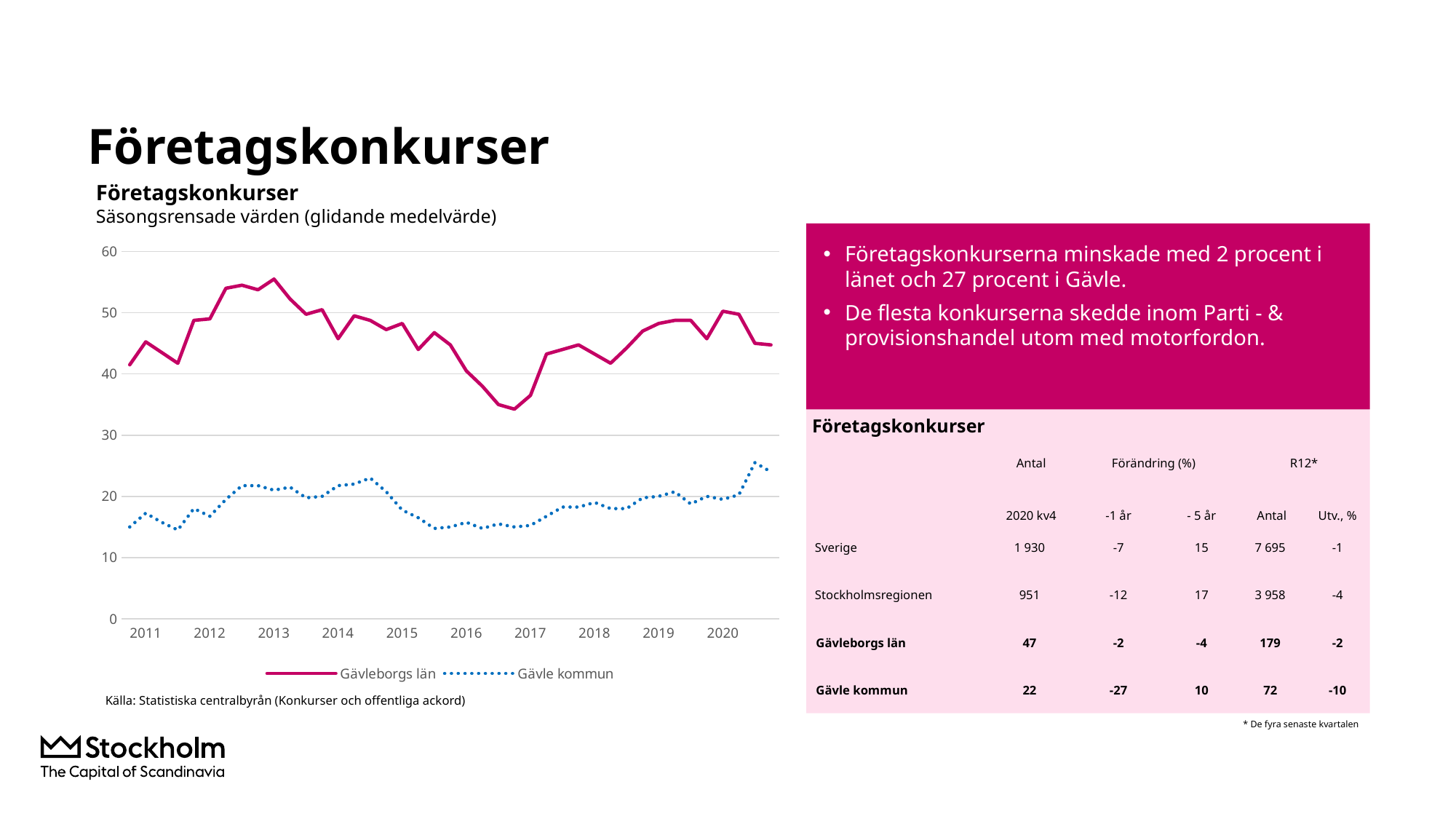
Is the value of the Gävle kommun line at the end of 2020 greater or less than 20? greater Is the value of the Gävle kommun line during 2016 greater or less than 20? less Is the lowest value of the Gävleborgs län line, around late 2016, greater or less than 40? less Does the Gävleborgs län line rise or fall between 2013 and 2016? fall What kind of chart is shown on the slide? line chart What are the two series named in the chart legend? Gävleborgs län and Gävle kommun How many series does the chart legend list? 2 Which series has higher values throughout the chart, Gävleborgs län or Gävle kommun? Gävleborgs län What is the subtitle shown under the chart title 'Företagskonkurser'? Säsongsrensade värden (glidande medelvärde) How many year labels are shown on the x axis of the chart? 10 Does the Gävle kommun line rise or fall from 2019 to the end of 2020? rise